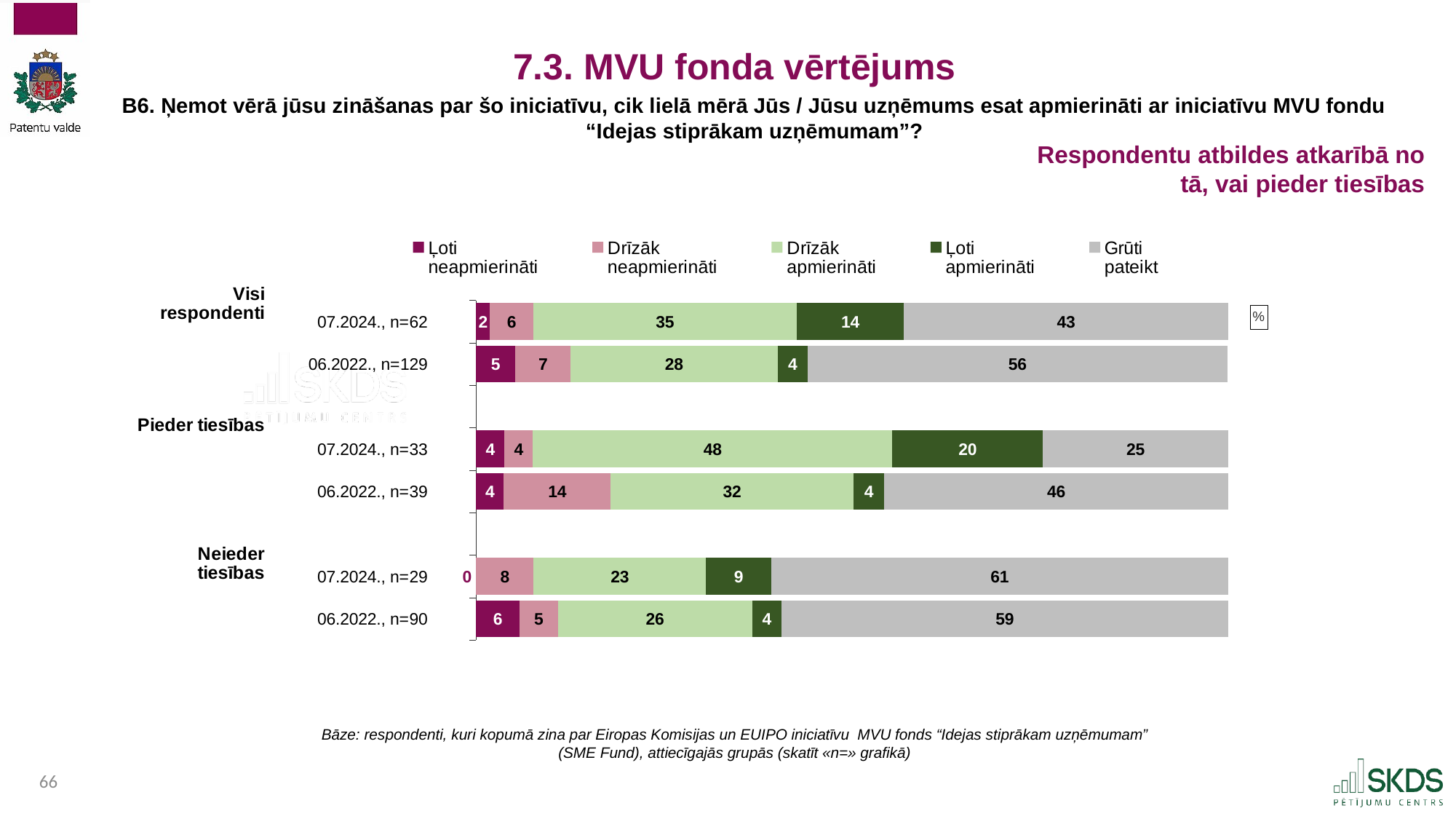
How many bars (survey rows) are plotted in the chart? 6 Which legend entry is shown in dark green? Ļoti apmierināti What kind of chart is shown on the slide? Stacked bar chart What is the value for "Ļoti neapmierināti" in the "Neieder tiesības" 07.2024., n=29 bar? 0 How many series does the legend list? 5 Which is larger: the "Drīzāk apmierināti" value for "Neieder tiesības" 07.2024., n=29 or for "Neieder tiesības" 06.2022., n=90? 06.2022., n=90 What is the value for "Grūti pateikt" in the "Visi respondenti" 07.2024., n=62 bar? 43 What is the value for "Drīzāk apmierināti" in the "Pieder tiesības" 07.2024., n=33 bar? 48 Which bar has the highest value for "Grūti pateikt"? Neieder tiesības, 07.2024., n=29 Which bar has the highest value for "Ļoti apmierināti"? Pieder tiesības, 07.2024., n=33 What is the difference between the "Grūti pateikt" values for "Visi respondenti" in 06.2022., n=129 and 07.2024., n=62? 13 What is the value for "Drīzāk neapmierināti" in the "Pieder tiesības" 06.2022., n=39 bar? 14